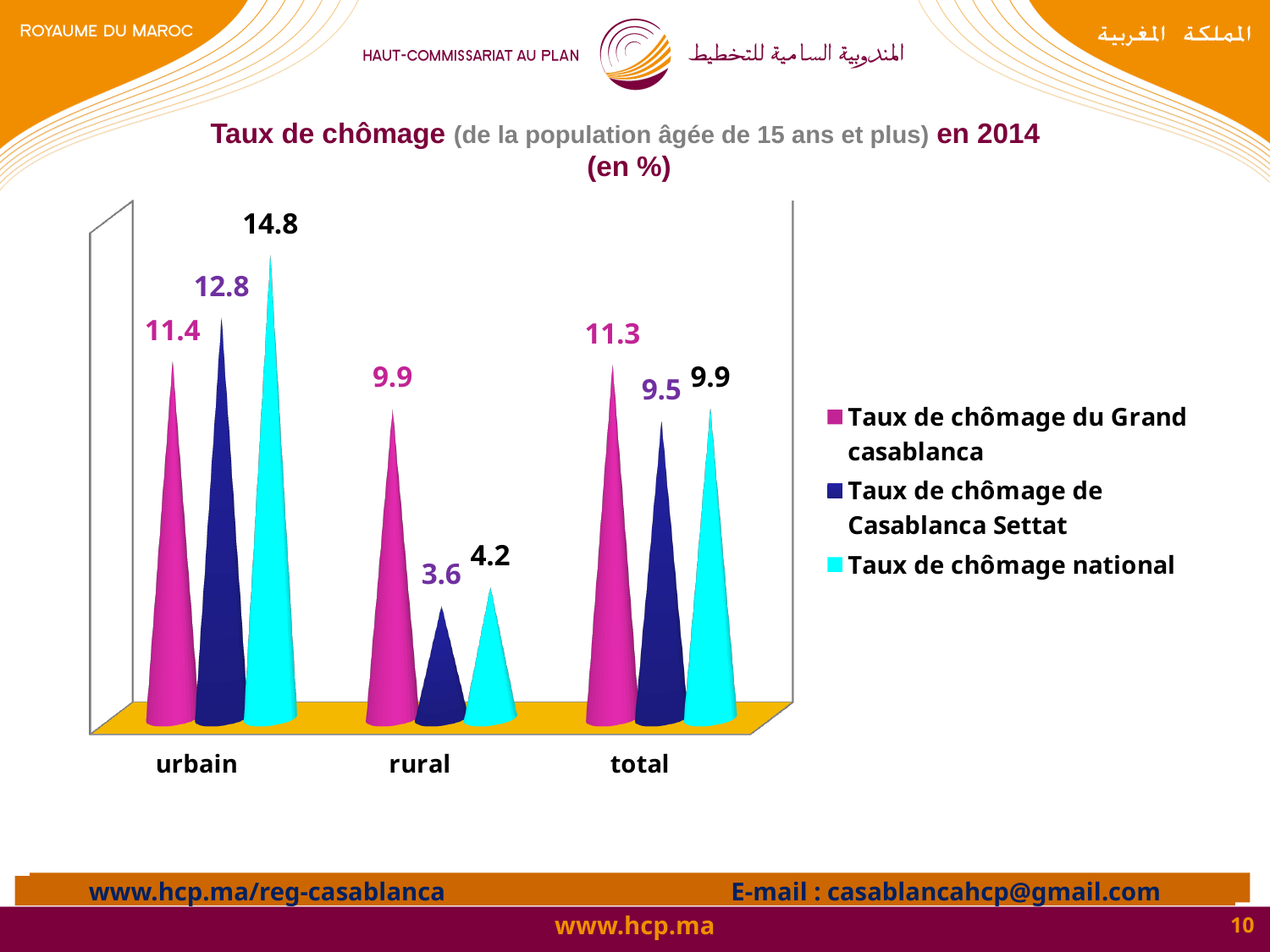
For rural, which is larger: the Taux de chômage du Grand casablanca or the Taux de chômage national? Taux de chômage du Grand casablanca Which category has the highest Taux de chômage national? urbain What is the Taux de chômage du Grand casablanca for total? 11.3 How many categories are shown on the x axis? 3 What is the Taux de chômage de Casablanca Settat for rural? 3.6 What colour represents the Taux de chômage national series? cyan What kind of chart is shown on the slide? bar chart Which category has the lowest Taux de chômage de Casablanca Settat? rural What is the difference between the Taux de chômage national and the Taux de chômage de Casablanca Settat for total? 0.4 What is the difference between the Taux de chômage national and the Taux de chômage du Grand casablanca for urbain? 3.4 What is the Taux de chômage national for urbain? 14.8 How many series does the legend list? 3